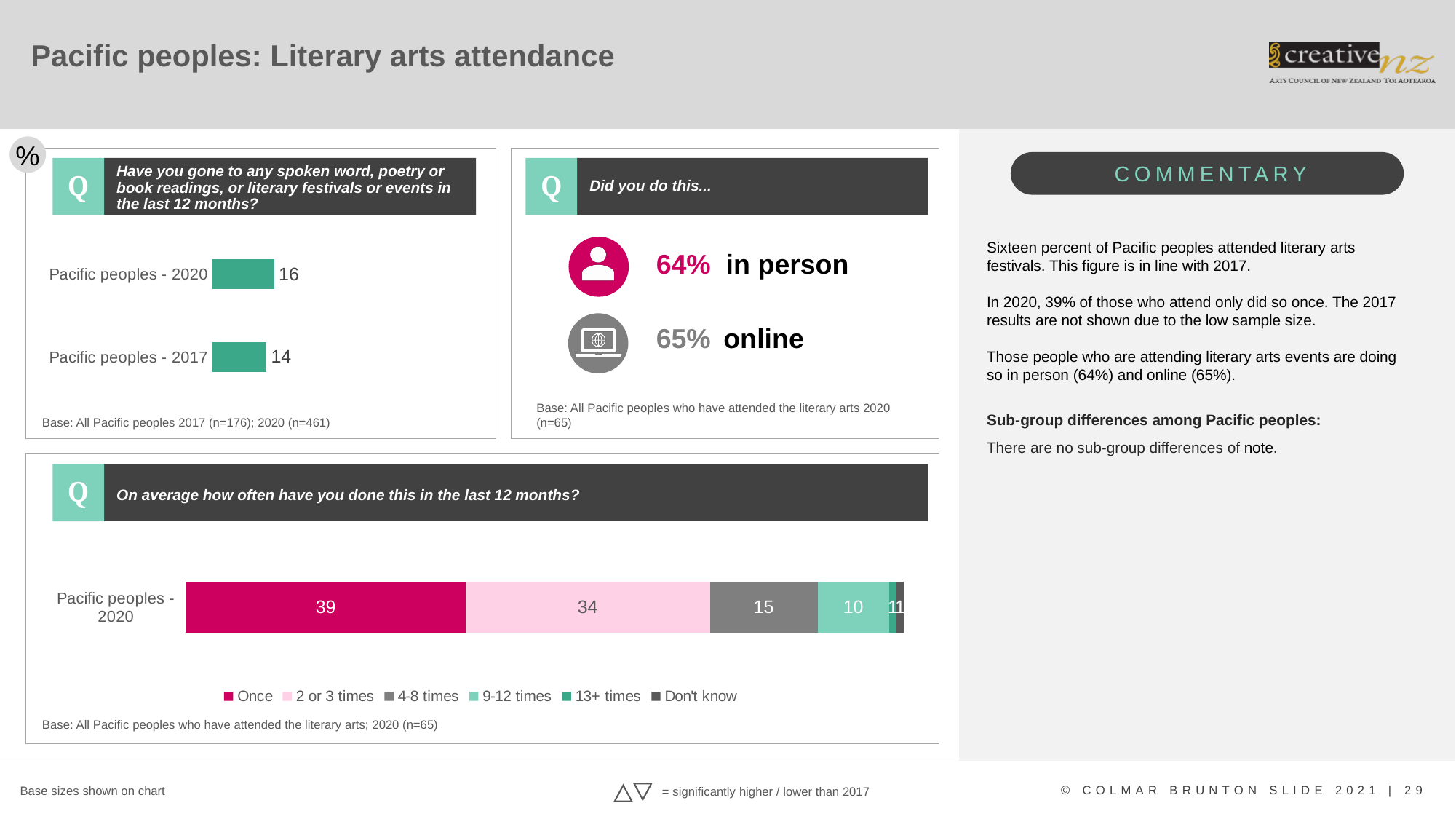
In the bottom chart on how often people attended in the last 12 months, how many series does the legend list? 6 In the bottom chart on how often people attended in the last 12 months, what is the value for '9-12 times'? 10 In the bottom chart on how often people attended in the last 12 months, what is the value for 'Once'? 39 In the top-left chart on literary arts attendance, what is the difference between the 2020 and 2017 values? 2 In the bottom chart on how often people attended in the last 12 months, what is the value for '4-8 times'? 15 In the top-left chart on literary arts attendance, which year has the higher value, 2020 or 2017? 2020 In the bottom chart on how often people attended in the last 12 months, which category has the largest segment? Once In the top-left chart on literary arts attendance in the last 12 months, what is the value for Pacific peoples - 2020? 16 In the top-left chart on literary arts attendance, how many bars are plotted? 2 In the bottom chart on how often people attended in the last 12 months, what is the value for '2 or 3 times'? 34 What type of chart is the top-left chart on literary arts attendance? Bar chart In the top-left chart on literary arts attendance in the last 12 months, what is the value for Pacific peoples - 2017? 14